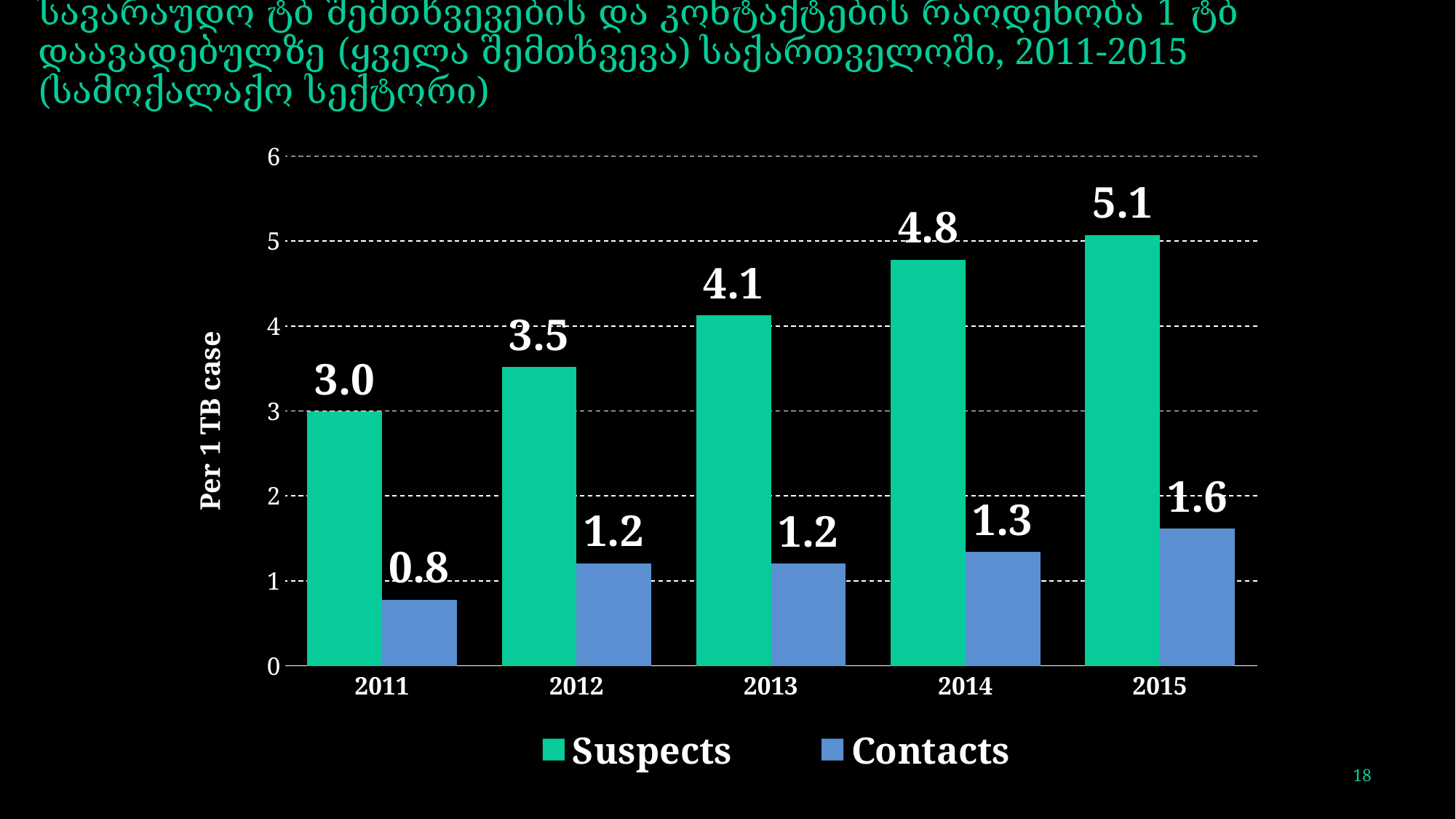
What is the difference between the Suspects values for 2015 and 2011? 2.1 Do the Suspects values rise or fall from 2011 to 2015? Rise Which is larger, the Contacts value in 2012 or in 2015? 2015 What is the difference between the Suspects and Contacts values in 2014? 3.5 What is the value for Suspects in 2013? 4.1 In which year is the Contacts value lowest? 2011 How many years are shown on the x axis? 5 How many series does the legend list? 2 What is the value for Contacts in 2011? 0.8 What kind of chart is shown on the slide? Bar chart In which year is the Suspects value highest? 2015 What is the value for Contacts in 2015? 1.6